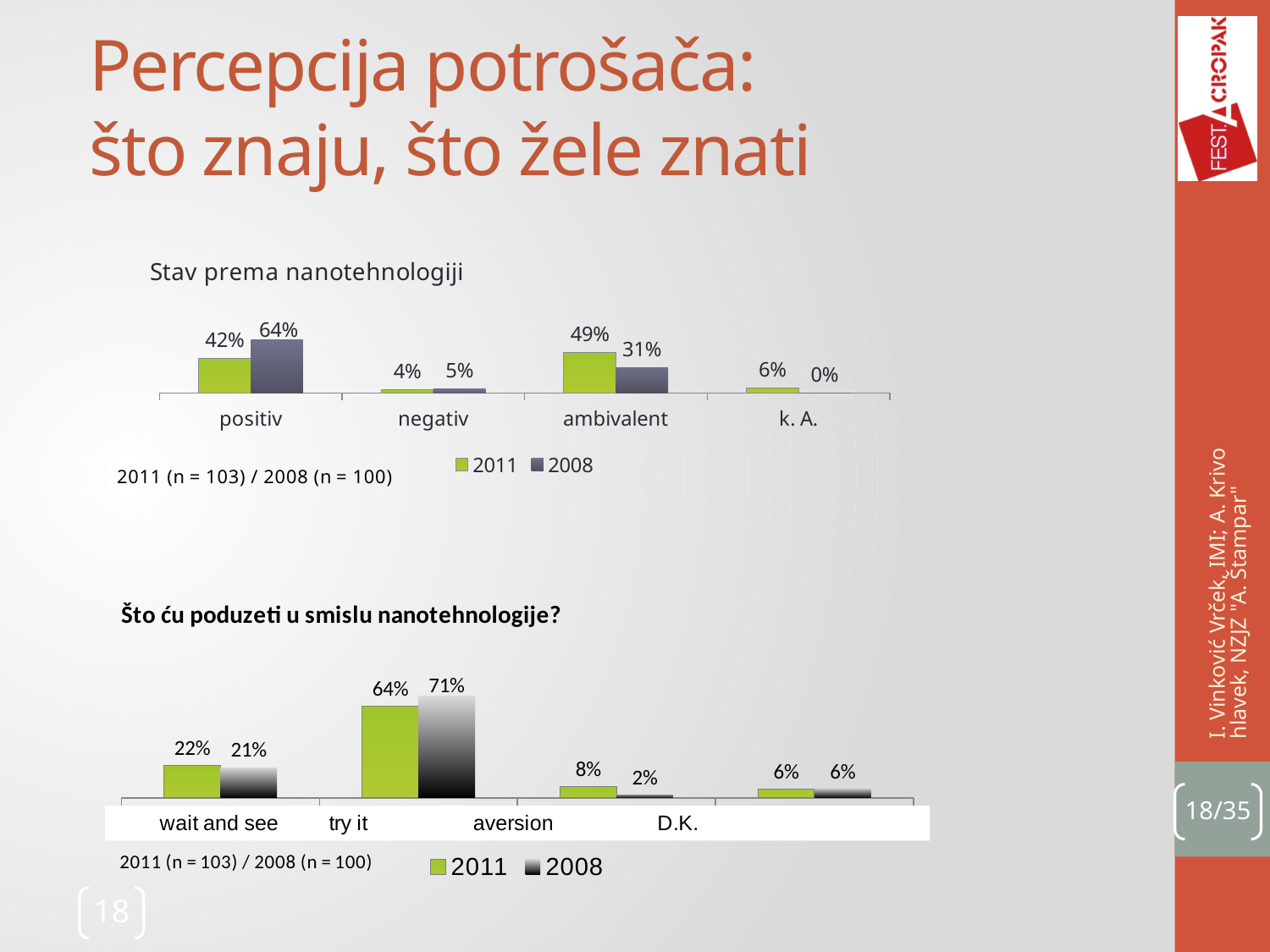
In the 'Stav prema nanotehnologiji' chart, which category has the lowest value for 2008? k. A. In the 'Stav prema nanotehnologiji' chart, what is the difference between the 2008 and 2011 values for 'positiv'? 22% What type of chart is the 'Stav prema nanotehnologiji' chart? bar chart In the 'Stav prema nanotehnologiji' chart, what is the value for 'positiv' in 2008? 64% In the 'Što ću poduzeti u smislu nanotehnologije?' chart, what is the value for 'aversion' in 2011? 8% In the 'Što ću poduzeti u smislu nanotehnologije?' chart, what is the difference between the 2011 and 2008 values for 'aversion'? 6% How many series does the legend of the 'Što ću poduzeti u smislu nanotehnologije?' chart list? 2 In the 'Stav prema nanotehnologiji' chart, what is the value for 'ambivalent' in 2011? 49% In the 'Što ću poduzeti u smislu nanotehnologije?' chart, what is the value for 'try it' in 2008? 71% In the 'Što ću poduzeti u smislu nanotehnologije?' chart, which is larger for 'wait and see': the 2011 value or the 2008 value? 2011 In the 'Stav prema nanotehnologiji' chart, which category has the highest value for 2011? ambivalent In the 'Stav prema nanotehnologiji' chart, how many categories are shown on the x axis? 4